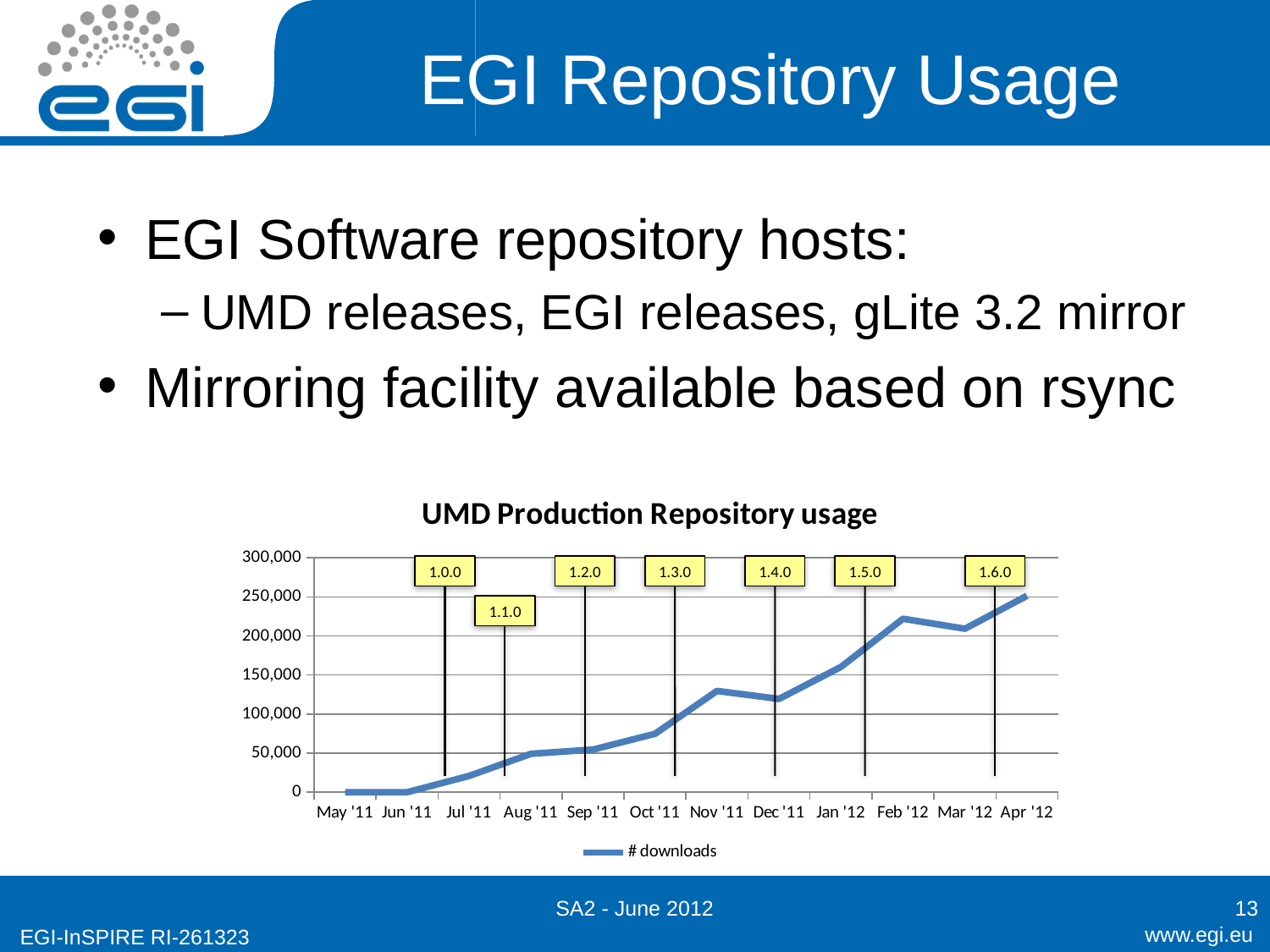
Do the download values generally rise or fall from May '11 to Apr '12? rise What is the name of the series shown in the legend? # downloads Is the value for Nov '11 greater or less than 100,000? greater How many series does the chart legend list? 1 Is the value for Oct '11 greater or less than 100,000? less What is the title of the chart? UMD Production Repository usage What kind of chart is shown on the slide? line chart Which has more downloads, Dec '11 or Feb '12? Feb '12 How many months are plotted along the x axis? 12 Which month has the highest number of downloads? Apr '12 Is the value for Jul '11 greater or less than 50,000? less